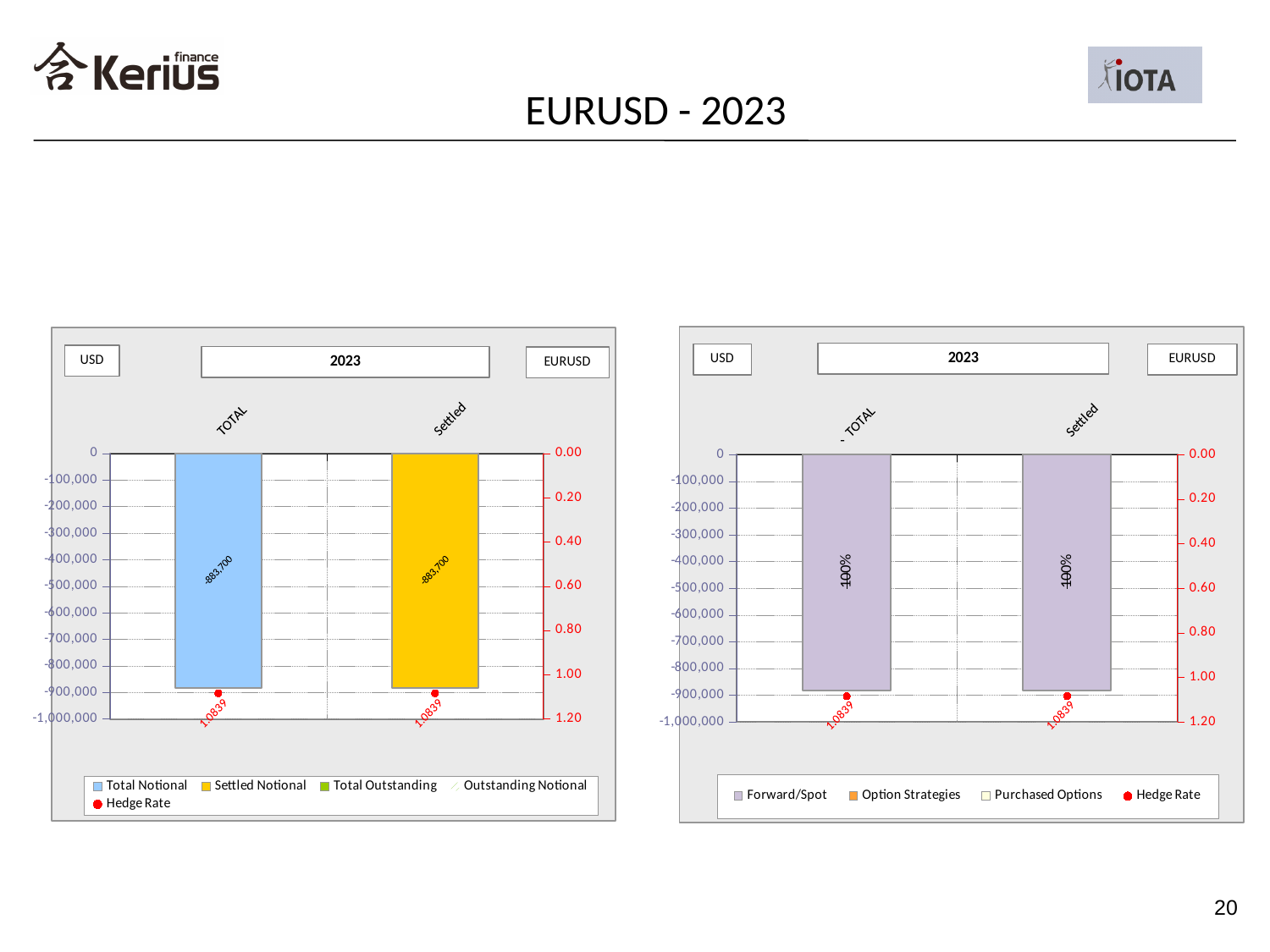
How many series does the legend of the left chart list? 5 In the right chart, what percentage is labelled on the Settled bar? 100% What kind of chart is the right chart? bar chart How many categories are shown on the x axis of the left chart? 2 In the left chart, which legend entry is shown in yellow? Settled Notional How many series does the legend of the right chart list? 4 In the left chart, what is the data label on the Settled bar? -883,700 In the left chart, what is the difference between the TOTAL and Settled bar values? 0 In the left chart, what is the data label on the TOTAL bar? -883,700 In the left chart, is the TOTAL bar value greater or less than -500,000? less In the left chart, what Hedge Rate value is labelled for TOTAL? 1.0839 In the right chart, what Hedge Rate value is labelled for Settled? 1.0839